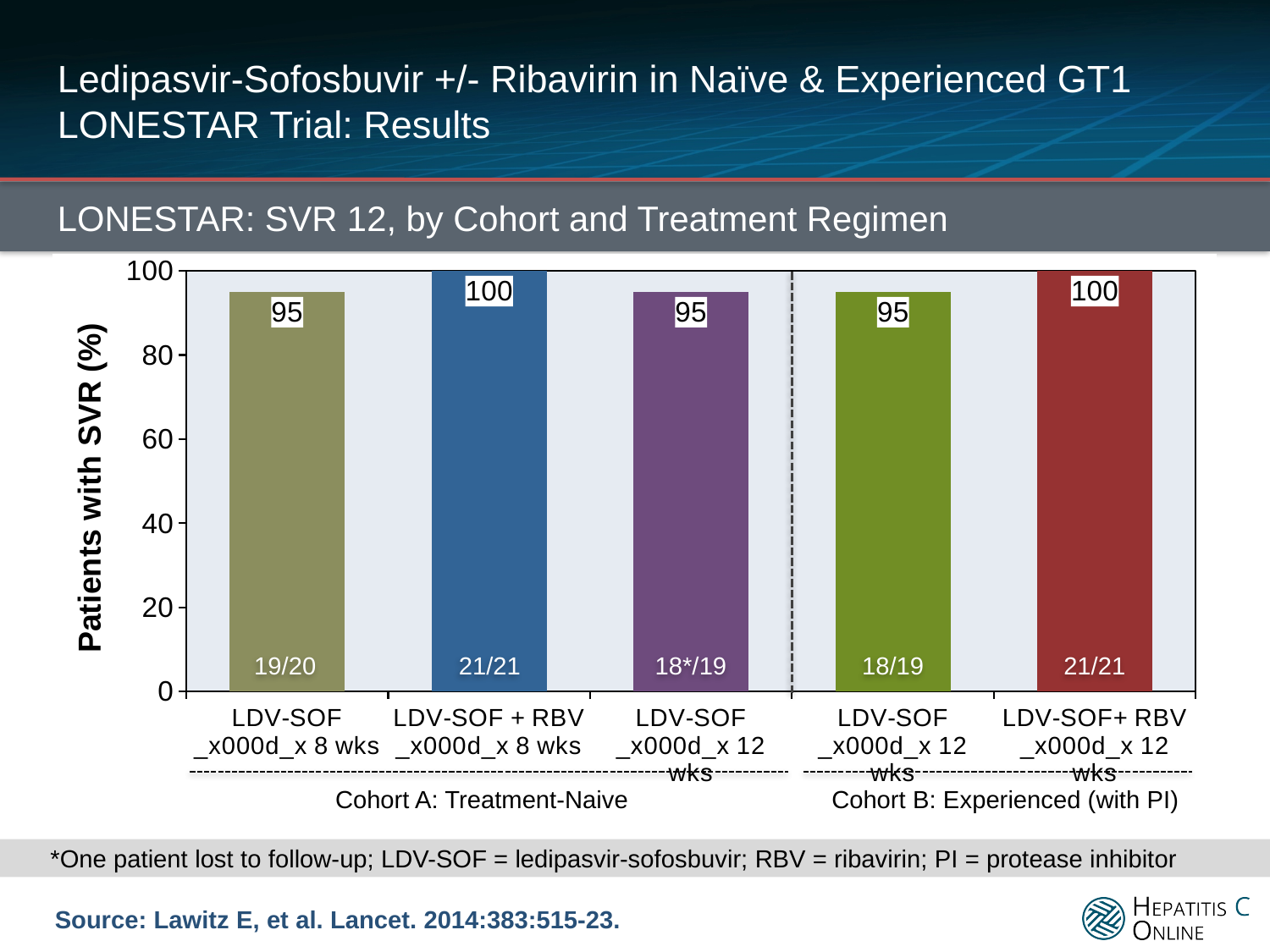
How many patients achieved SVR out of the total for LDV-SOF x 8 wks in Cohort A? 19/20 What type of chart is shown on the slide? bar chart What is the SVR 12 rate for LDV-SOF + RBV x 8 wks in Cohort A (Treatment-Naive)? 100 How many patients achieved SVR out of the total for LDV-SOF x 12 wks in Cohort A (Treatment-Naive)? 18*/19 What is the difference between the SVR 12 rate for LDV-SOF + RBV x 8 wks and LDV-SOF x 8 wks in Cohort A? 5 What is the SVR 12 rate for LDV-SOF x 8 wks in Cohort A (Treatment-Naive)? 95 Which has the higher SVR 12 rate in Cohort B: LDV-SOF x 12 wks or LDV-SOF+ RBV x 12 wks? LDV-SOF+ RBV x 12 wks What is the label of the y-axis of the chart? Patients with SVR (%) What is the SVR 12 rate for LDV-SOF+ RBV x 12 wks in Cohort B (Experienced with PI)? 100 What is the highest SVR 12 value shown in the chart? 100 What is the SVR 12 rate for LDV-SOF x 12 wks in Cohort B (Experienced with PI)? 95 How many bars are plotted in the chart? 5